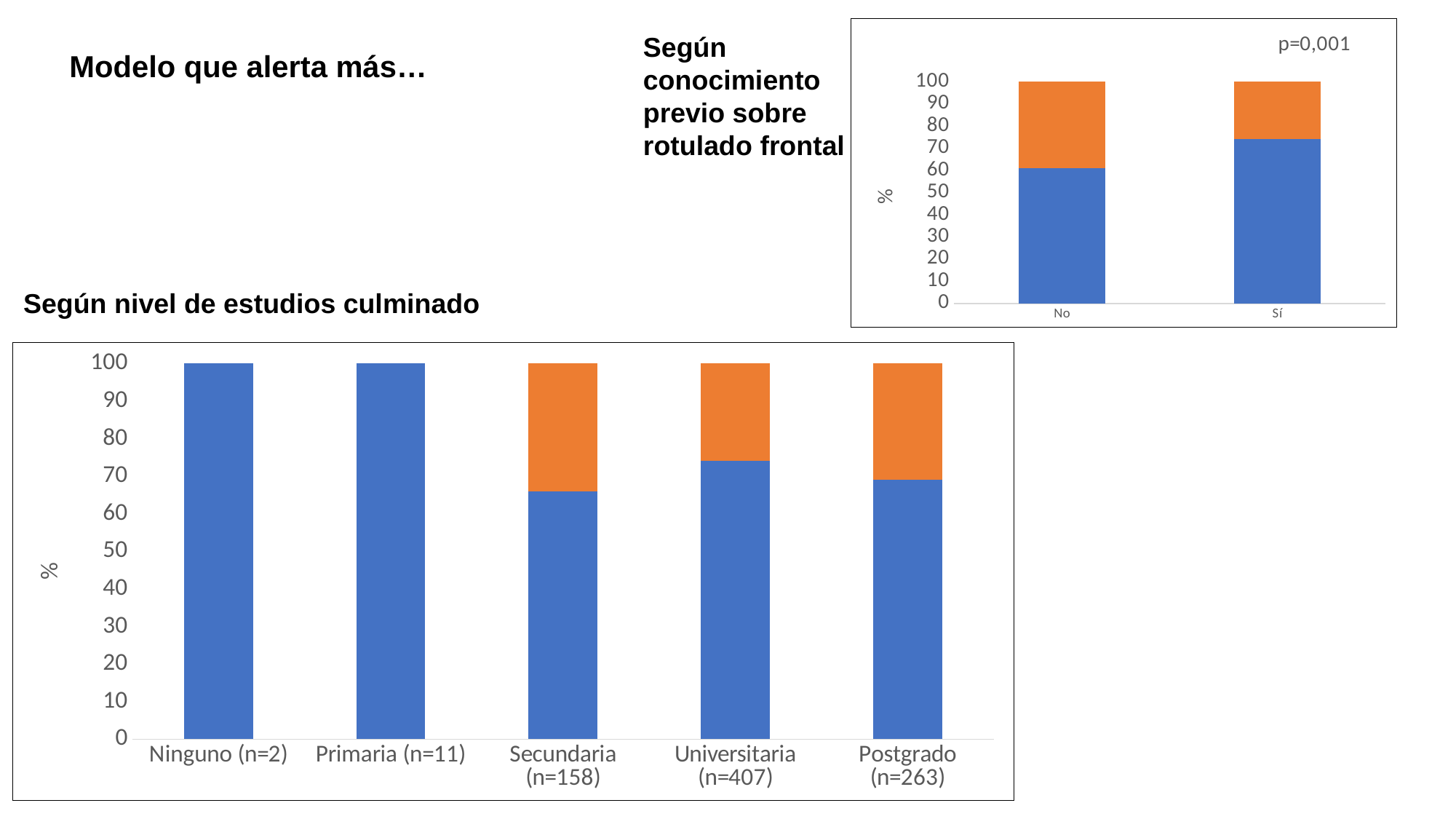
In the 'Según nivel de estudios culminado' chart, what is the total height of the stacked bar for Ninguno (n=2)? 100 In the 'Según conocimiento previo sobre rotulado frontal' chart, is the blue segment for 'No' greater or less than 50? greater In the 'Según nivel de estudios culminado' chart, which category has the largest orange segment? Secundaria (n=158) In the 'Según nivel de estudios culminado' chart, is the blue segment for Universitaria (n=407) larger or smaller than the blue segment for Secundaria (n=158)? larger In the 'Según nivel de estudios culminado' chart, is the blue segment for Universitaria (n=407) greater or less than 70? greater In the 'Según nivel de estudios culminado' chart, which category has the smallest blue segment? Secundaria (n=158) In the 'Según nivel de estudios culminado' chart, is the blue segment for Secundaria (n=158) greater or less than 70? less What kind of chart is the 'Según nivel de estudios culminado' chart? stacked bar chart How many education-level categories are shown on the x axis of the 'Según nivel de estudios culminado' chart? 5 In the 'Según conocimiento previo sobre rotulado frontal' chart, is the blue segment for 'Sí' larger or smaller than the blue segment for 'No'? larger What p-value is printed on the 'Según conocimiento previo sobre rotulado frontal' chart? p=0,001 How many categories are shown on the x axis of the 'Según conocimiento previo sobre rotulado frontal' chart? 2